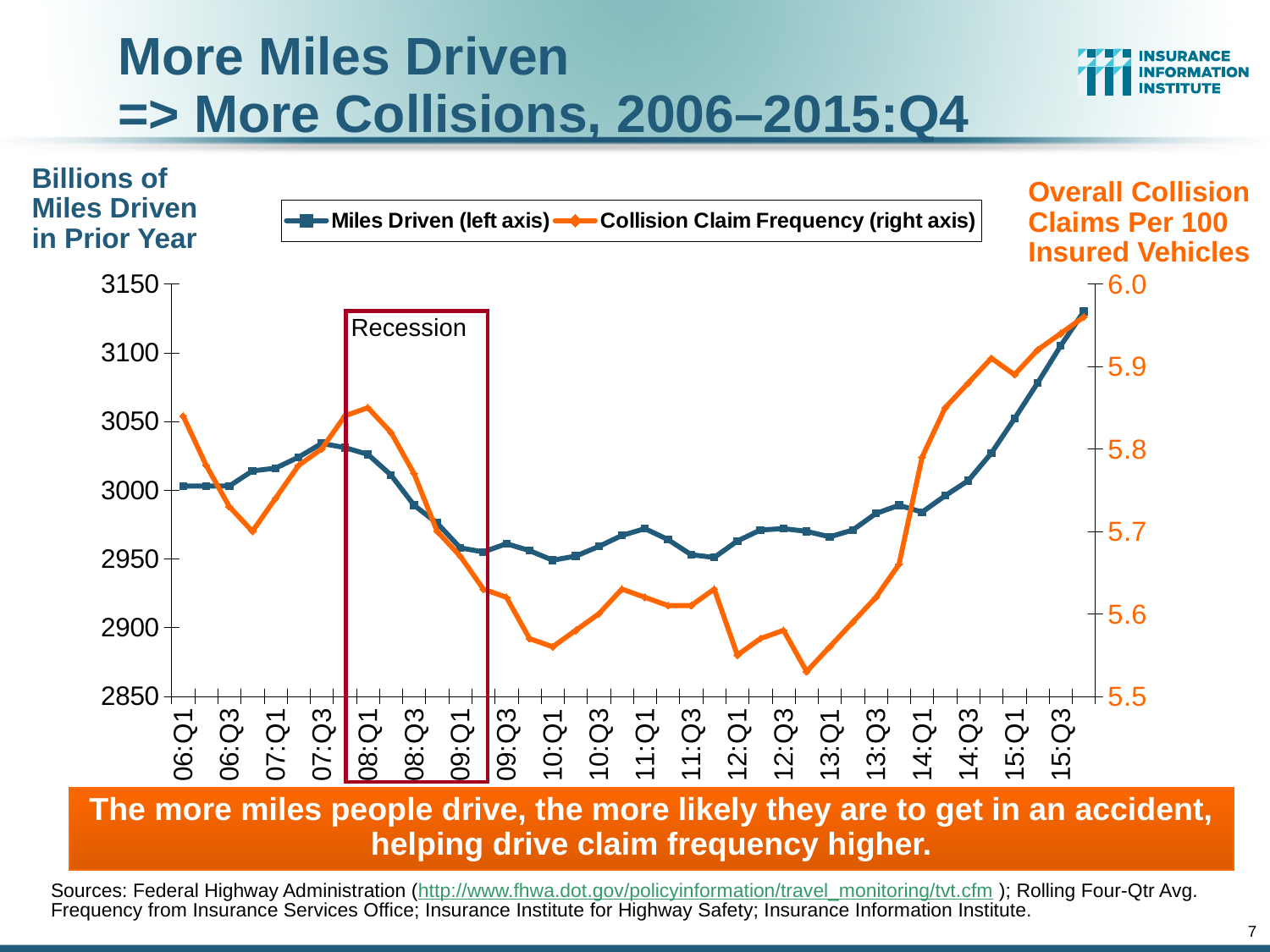
Which is larger, Miles Driven at 07:Q3 or Miles Driven at 10:Q1? 07:Q3 Is the Miles Driven value at 07:Q3 greater or less than 3000? greater What kind of chart is shown on the slide? Line chart Is the Collision Claim Frequency value at 13:Q1 greater or less than 5.6? less Which is larger, Collision Claim Frequency at 08:Q1 or at 12:Q1? 08:Q1 Does the Collision Claim Frequency rise or fall from 13:Q1 to 15:Q3? rise What label is shown inside the highlighted box on the chart? Recession Is the Collision Claim Frequency value at 08:Q1 greater or less than 5.8? greater Which series is plotted against the right axis? Collision Claim Frequency Which quarter has the lowest Collision Claim Frequency? 12:Q4 How many series does the legend list? 2